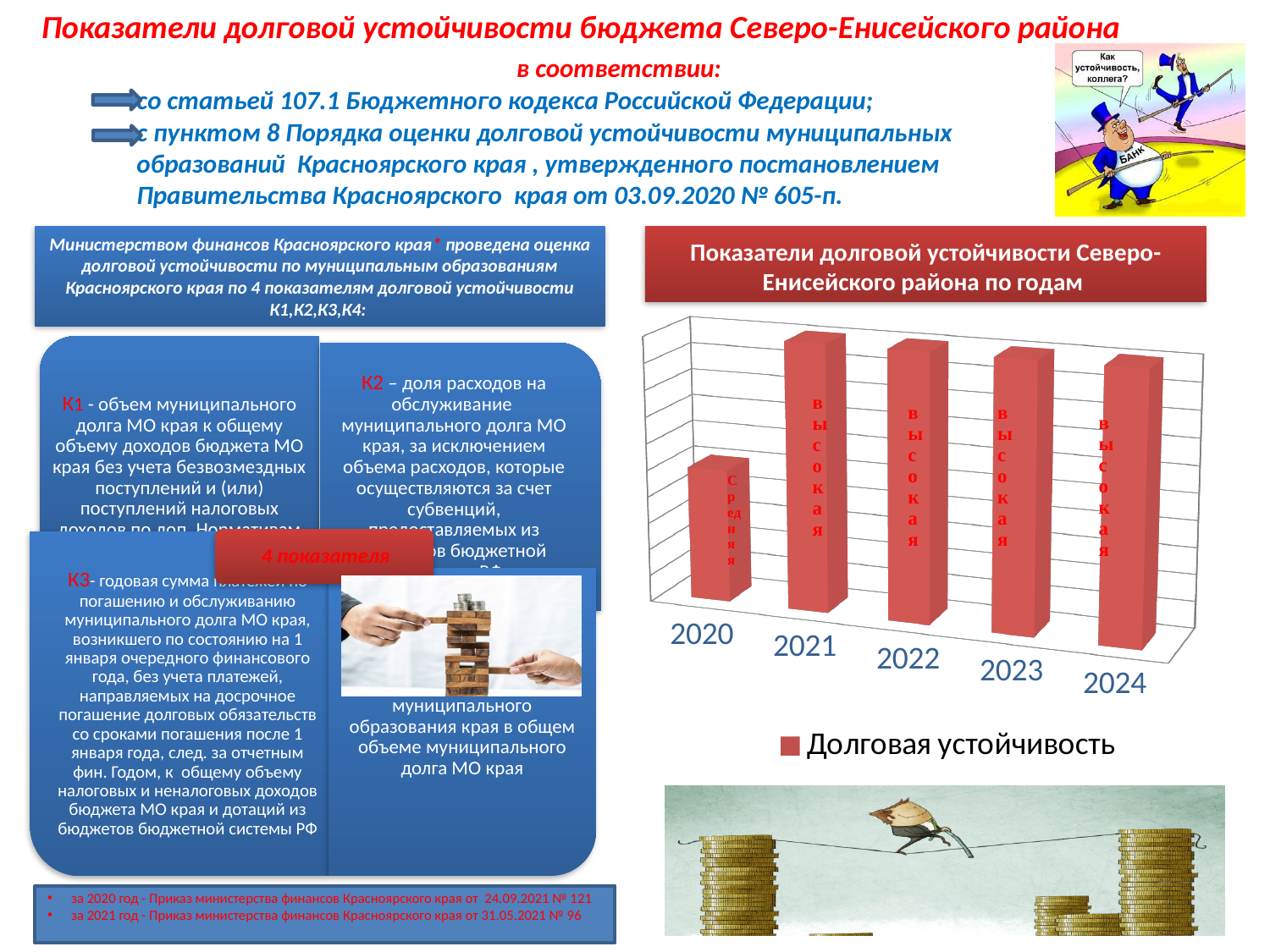
What is the name of the series in the chart legend? Долговая устойчивость What text label is written on the bar for 2023? Высокая What text label is written on the bar for 2020? Средняя How many years are shown on the x axis of the chart? 5 Do the bars rise or fall from 2021 to 2024? Neither; they stay the same Which year has the lowest bar in the chart? 2020 What is the title of the chart on the slide? Показатели долговой устойчивости Северо-Енисейского района по годам How many series does the chart legend list? 1 Which bar is taller, 2020 or 2021? 2021 What kind of chart is shown on the slide? bar chart Which bar is taller, 2020 or 2024? 2024